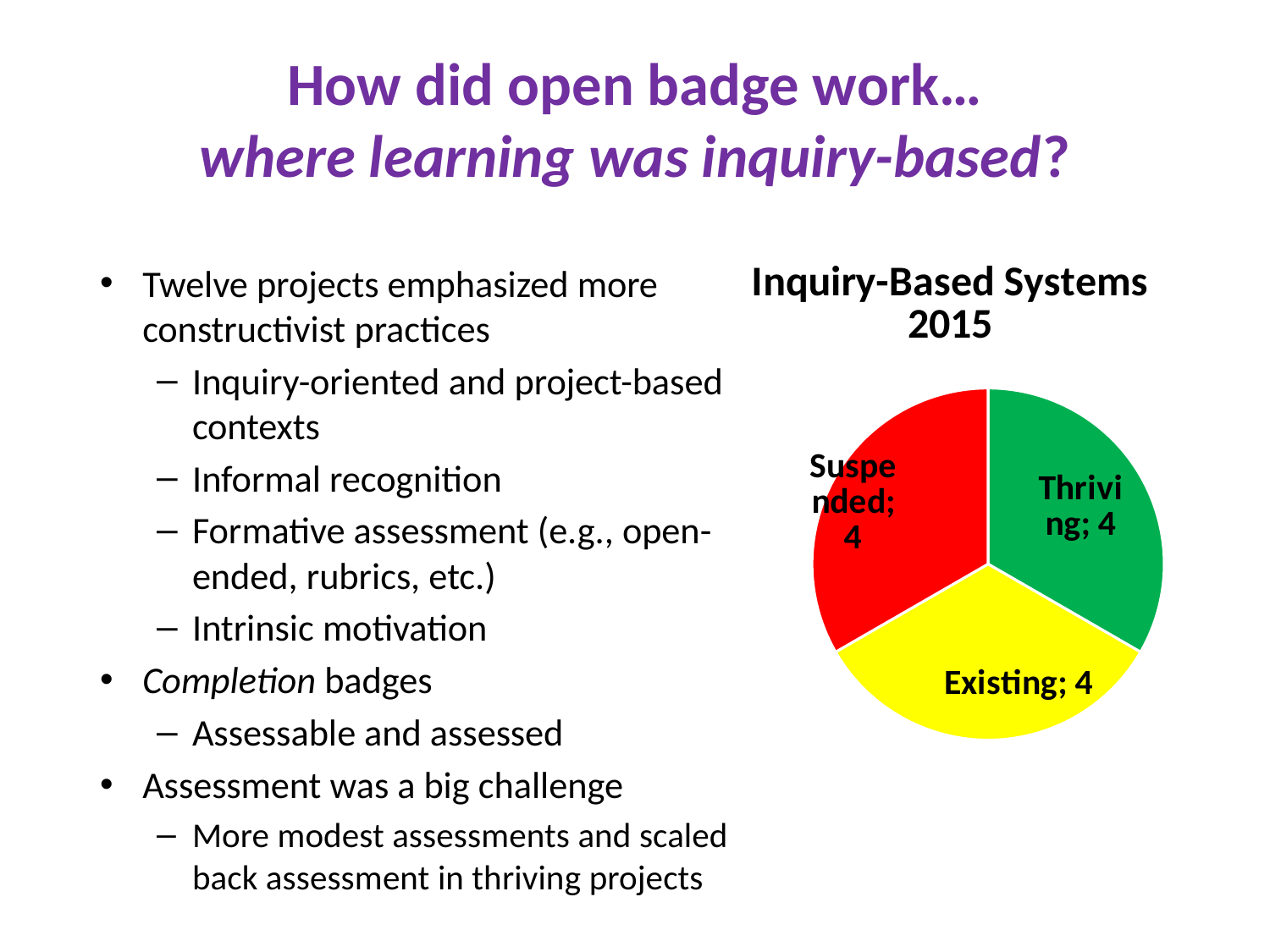
What is the value for Existing in the pie chart? 4 What is the difference between the values for Thriving and Suspended? 0 What is the total of all slices in the pie chart? 12 What kind of chart is shown on the slide? pie chart How many slices does the pie chart have? 3 Do the three slices of the pie chart have equal values? yes What share of the pie does the Existing slice represent? one third What is the value for Suspended in the pie chart? 4 Which colour is used for the Suspended slice? red What is the value for Thriving in the pie chart? 4 What is the title of the chart? Inquiry-Based Systems 2015